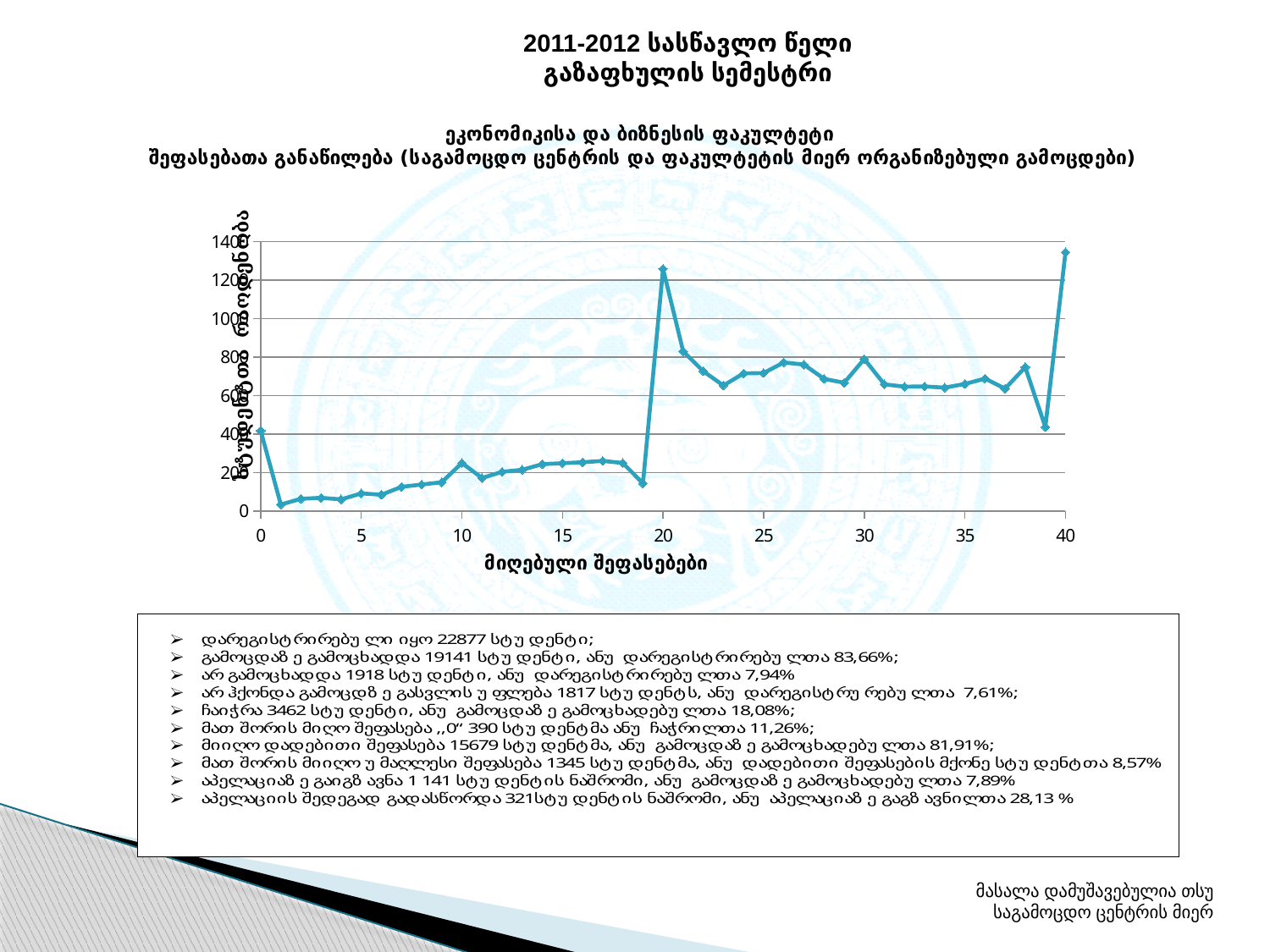
What kind of chart is shown on the slide? line chart What is the title of the x axis of the chart? მიღებული შეფასებები Is the value for score 40 greater or less than 1200? greater Is the value for score 20 greater or less than 1000? greater Which score on the x axis has the highest number of students? 40 Is the value for score 30 greater or less than 600? greater Which score on the x axis has the lowest number of students? 1 What is the highest value shown on the y axis of the chart? 1400 Which has more students, score 20 or score 10? score 20 Do the values rise or fall along the x axis between score 1 and score 10? rise